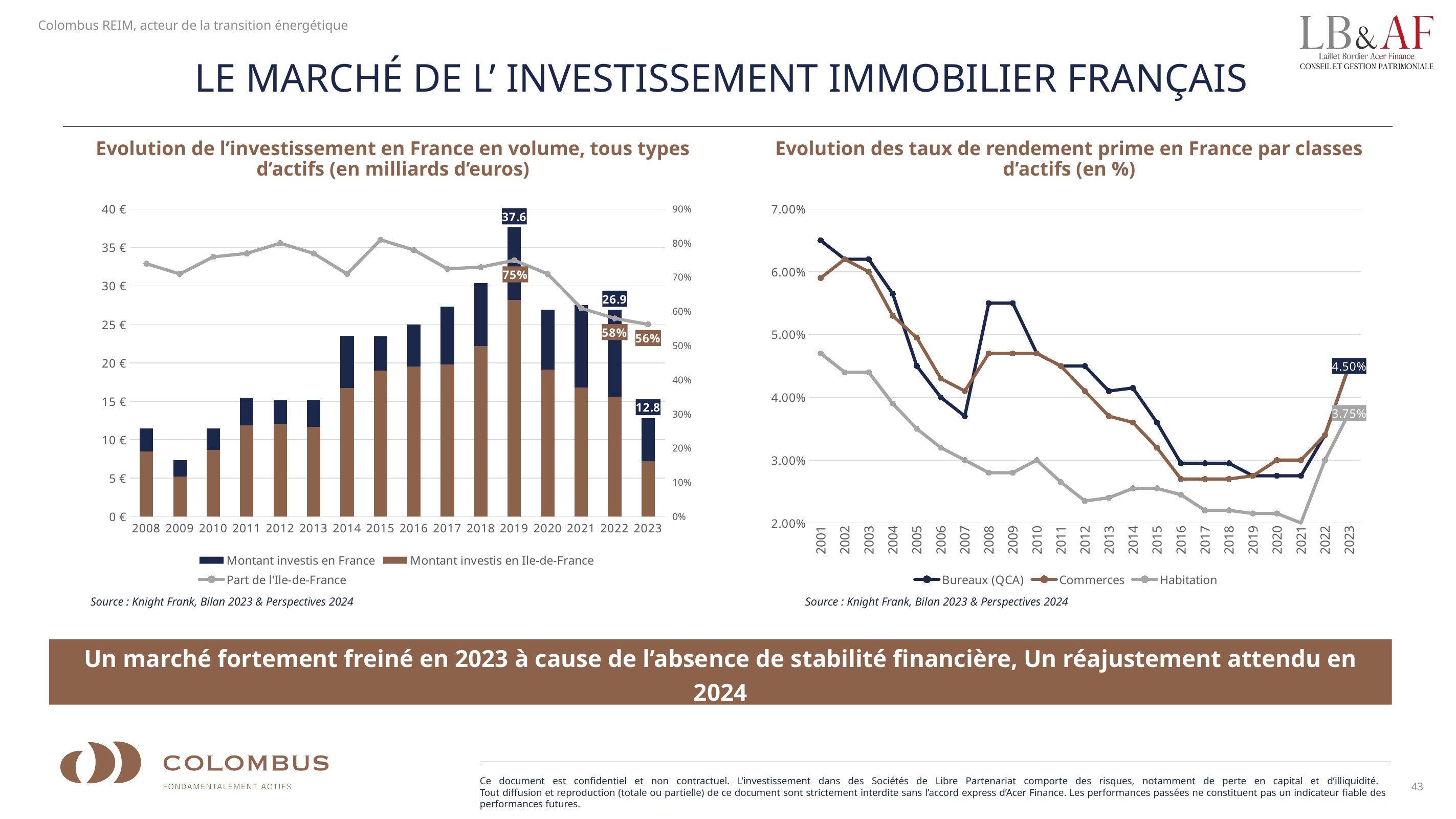
In the left chart, which year has the lowest Montant investis en France? 2009 In the left chart, how many series does the legend list? 3 In the left chart, what is the Part de l'Ile-de-France shown for 2019? 75% In the right chart, is the value for Bureaux (QCA) in 2001 greater or less than 6.00%? greater In the right chart, how many series does the legend list? 3 In the left chart (Evolution de l'investissement en France en volume), what is the value of Montant investis en France for 2019? 37.6 In the left chart, which year has the highest Montant investis en France? 2019 In the right chart (Evolution des taux de rendement prime), what is the value for Habitation in 2023? 3.75% In the right chart, which year has the lowest value for Habitation? 2021 In the left chart, how many years are shown on the x axis? 16 In the left chart, what is the difference between the Montant investis en France values for 2019 and 2023? 24.8 In the left chart (Evolution de l'investissement en France en volume), what is the value of Montant investis en France for 2023? 12.8